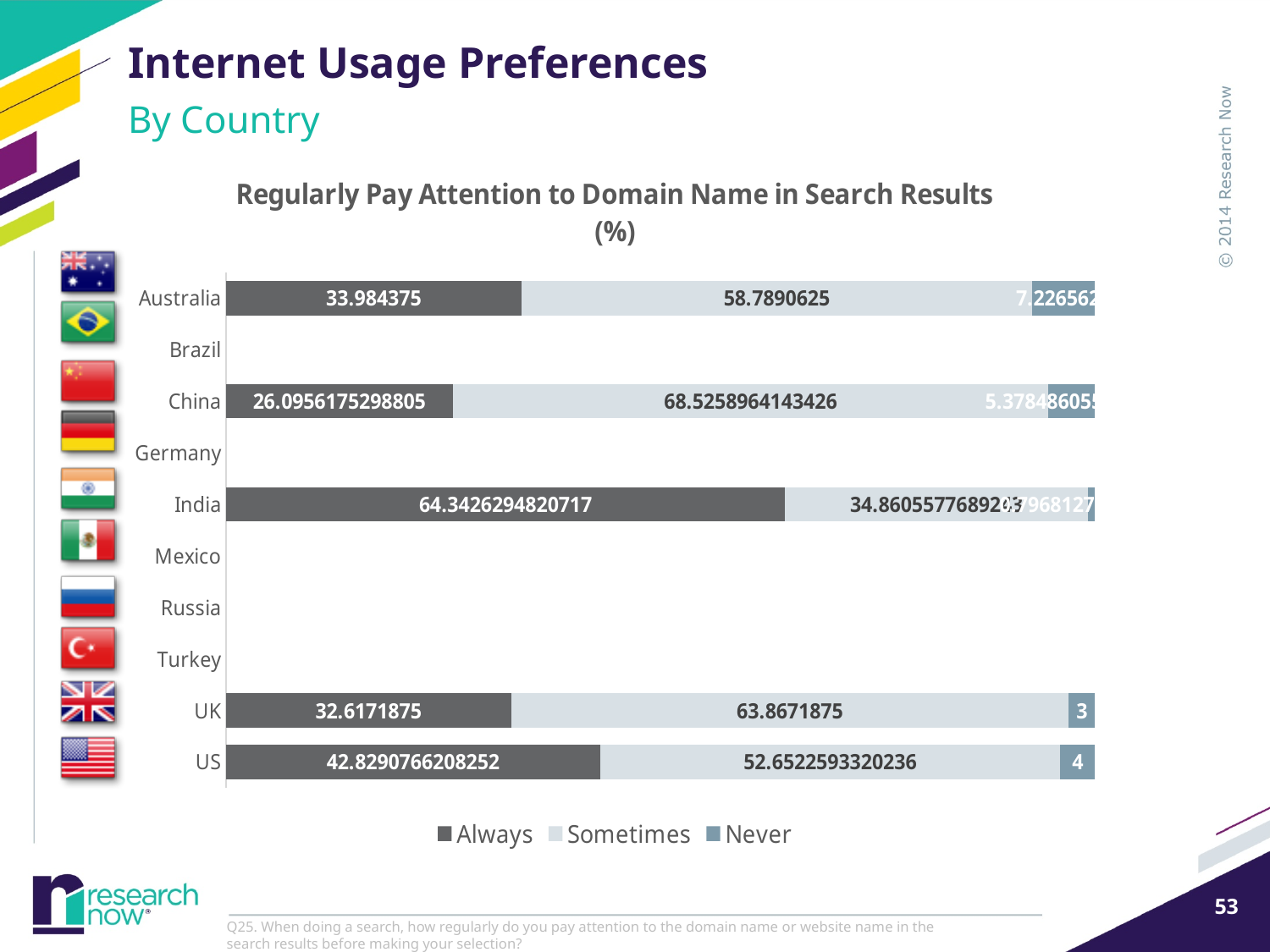
What is the 'Sometimes' value for the UK? 63.8671875 What kind of chart is shown on the slide? Stacked bar chart What is the difference between the 'Always' values for Australia and the UK? 1.3671875 What is the 'Never' value for the US? 4 How many series does the legend list? 3 What is the 'Always' value for Australia? 33.984375 Among the countries with plotted bars, which has the lowest 'Always' value? China Which has a larger 'Sometimes' value, Australia or the US? Australia How many countries are listed on the chart's category axis? 10 What is the 'Always' value for China? 26.0956175298805 Which country has the highest 'Always' value? India What is the 'Always' value for India? 64.3426294820717